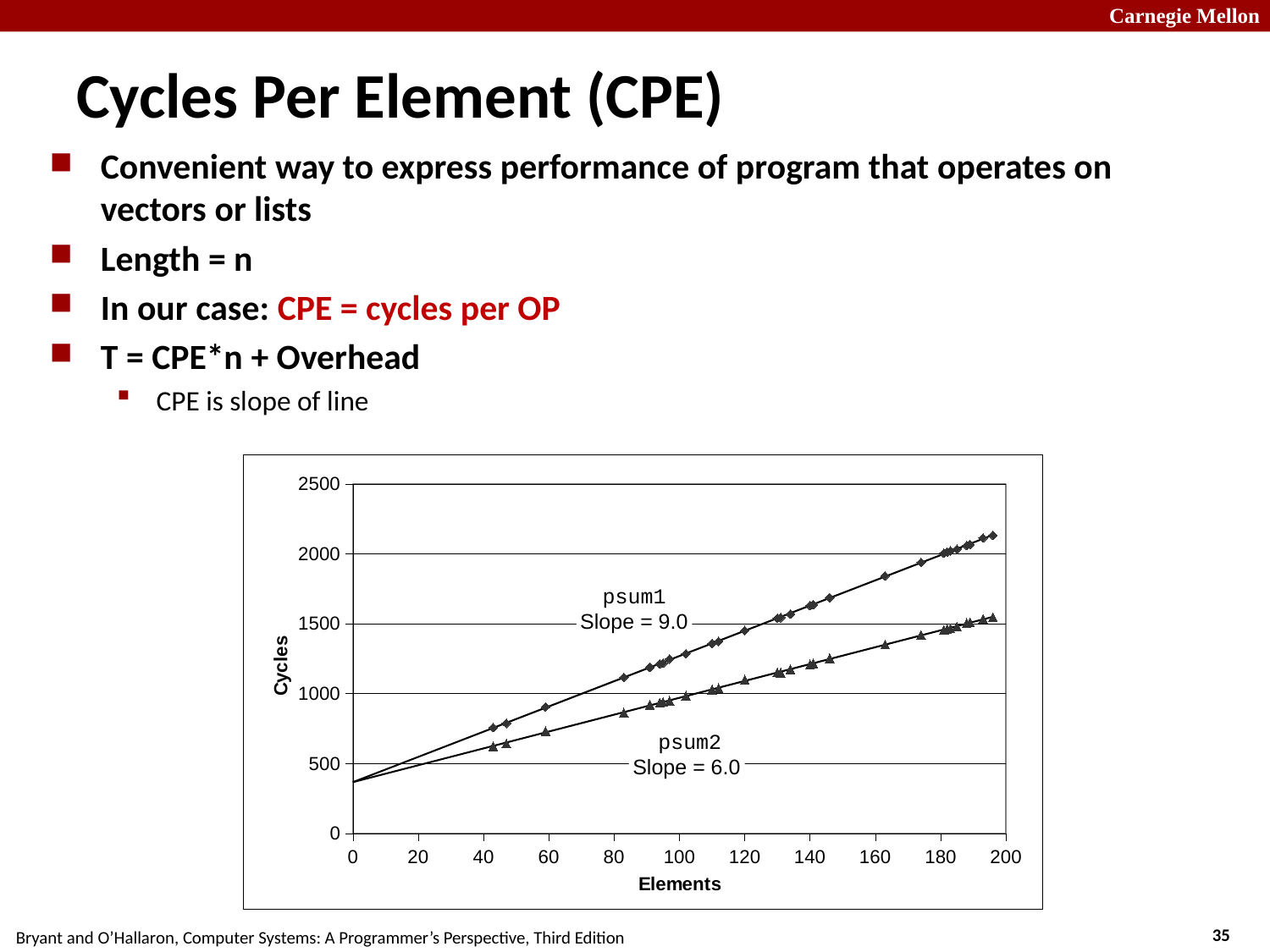
What is the difference between the slopes of psum1 and psum2? 3.0 What is the label of the y axis of the chart? Cycles What kind of chart is shown on the slide? Line chart (scatter with lines) Is the value of psum1 at about 195 elements greater or less than 2000 cycles? greater What is the label of the x axis of the chart? Elements What is the slope of the psum2 line according to the chart annotation? 6.0 How many data series are plotted in the chart? 2 What is the slope of the psum1 line according to the chart annotation? 9.0 Which series has the larger slope, psum1 or psum2? psum1 Is the value of psum1 at about 100 elements greater or less than 1000 cycles? greater Is the value of psum2 at about 160 elements greater or less than 1500 cycles? less Do the cycle counts rise or fall as the number of elements increases? Rise